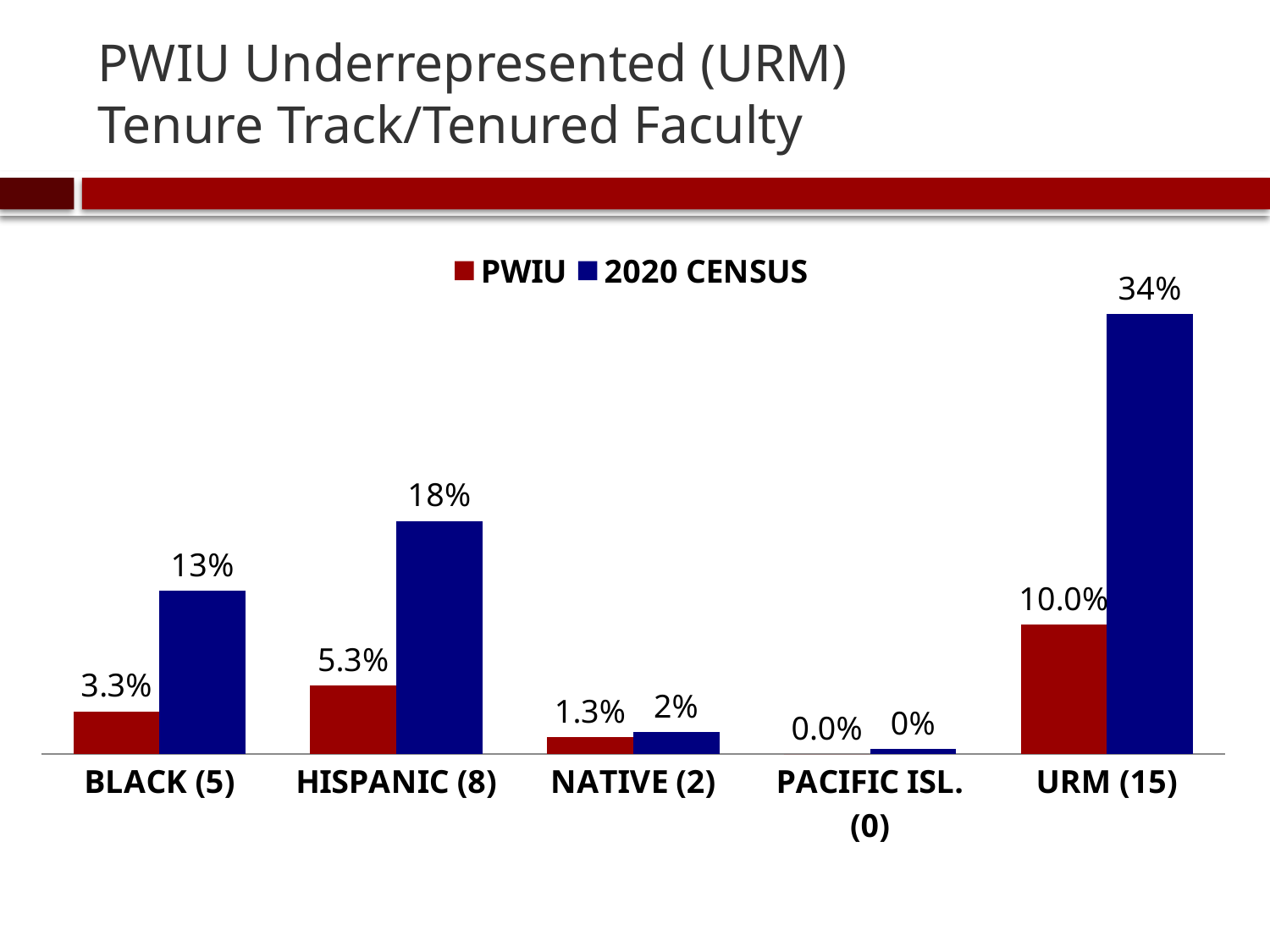
What is the difference between the 2020 CENSUS value and the PWIU value for URM (15)? 24% What is the 2020 CENSUS value for HISPANIC (8)? 18% How many categories are shown on the x axis? 5 What is the PWIU value for BLACK (5)? 3.3% How many series does the legend list? 2 Which series is shown in dark red? PWIU What is the 2020 CENSUS value for NATIVE (2)? 2% Which is larger for HISPANIC (8): the PWIU value or the 2020 CENSUS value? 2020 CENSUS What kind of chart is shown on the slide? Bar chart What is the PWIU value for URM (15)? 10.0% Which category has the lowest PWIU value? PACIFIC ISL. (0) Which category has the highest 2020 CENSUS value? URM (15)